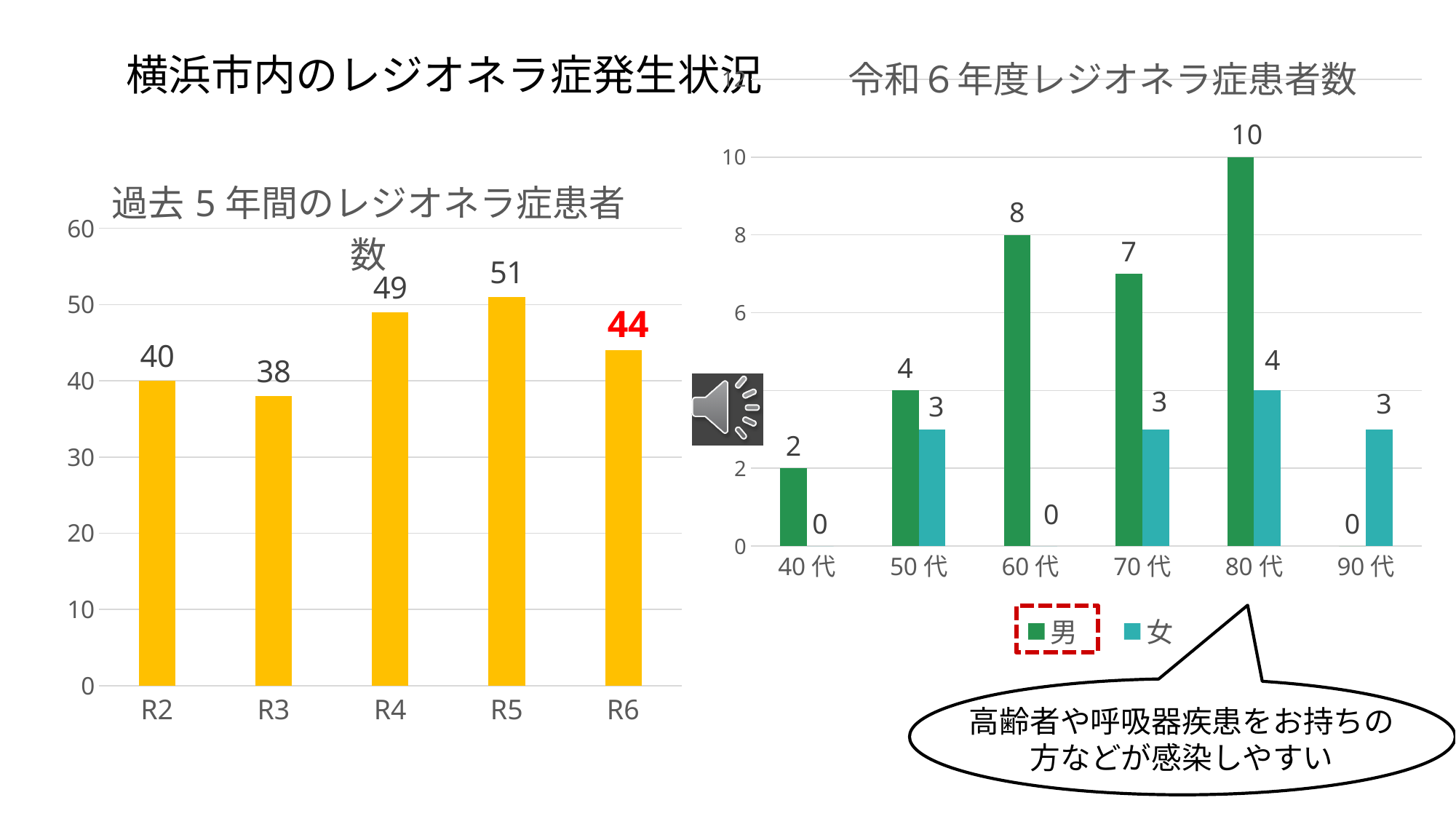
In the left chart (過去5年間のレジオネラ症患者数), which year has the highest value? R5 In the right chart (令和6年度レジオネラ症患者数), how many series does the legend list? 2 In the left chart (過去5年間のレジオネラ症患者数), which year has the lowest value? R3 In the left chart (過去5年間のレジオネラ症患者数), what is the difference between the values for R5 and R6? 7 In the left chart (過去5年間のレジオネラ症患者数), how many years are shown on the x axis? 5 In the left chart (過去5年間のレジオネラ症患者数), what is the value for R5? 51 What kind of chart is the right chart (令和6年度レジオネラ症患者数)? bar chart In the right chart (令和6年度レジオネラ症患者数), which age group has the highest value for 男? 80代 In the left chart (過去5年間のレジオネラ症患者数), is the value for R2 greater or less than 30? greater In the right chart (令和6年度レジオネラ症患者数), which is larger in the 70代 group, 男 or 女? 男 In the right chart (令和6年度レジオネラ症患者数), what is the value for 男 in the 80代 group? 10 In the right chart (令和6年度レジオネラ症患者数), what is the value for 女 in the 50代 group? 3